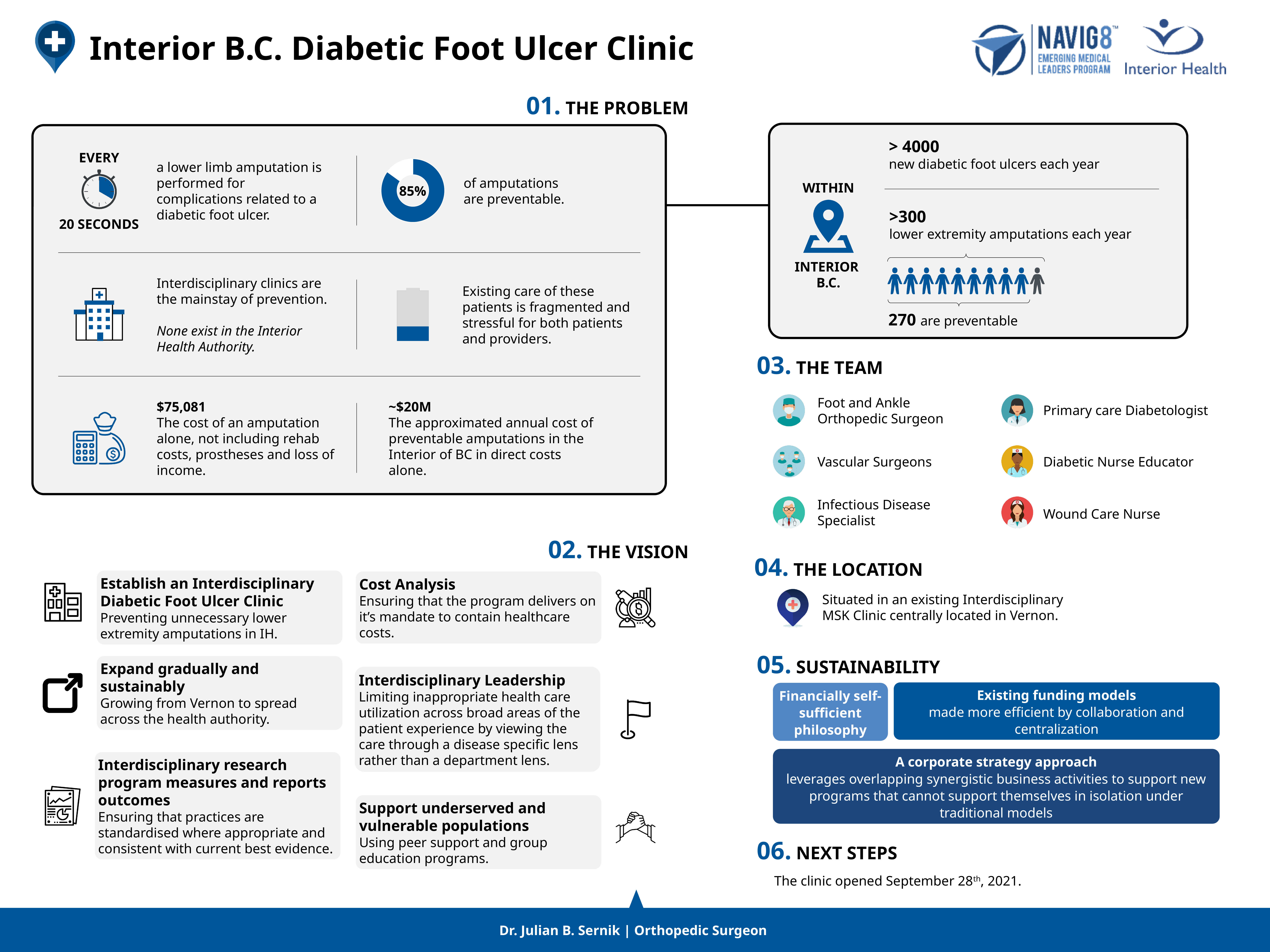
What kind of chart is used to show the share of amputations that are preventable? Pie (donut) chart What number of amputations does the pictogram label as preventable? 270 How many person icons are shown in the pictogram under '>300 lower extremity amputations each year'? 10 How many of the person icons in the pictogram are coloured grey? 1 How many of the person icons in the pictogram are coloured blue? 9 How many new diabetic foot ulcers each year are reported for Interior B.C.? > 4000 In the donut chart, which segment is larger: the preventable amputations segment or the remaining segment? Preventable amputations According to the donut chart in the problem section, what percentage of amputations are preventable? 85% In the donut chart, is the preventable share of amputations greater or less than 50%? greater What colour is the 85% segment of the donut chart? Blue